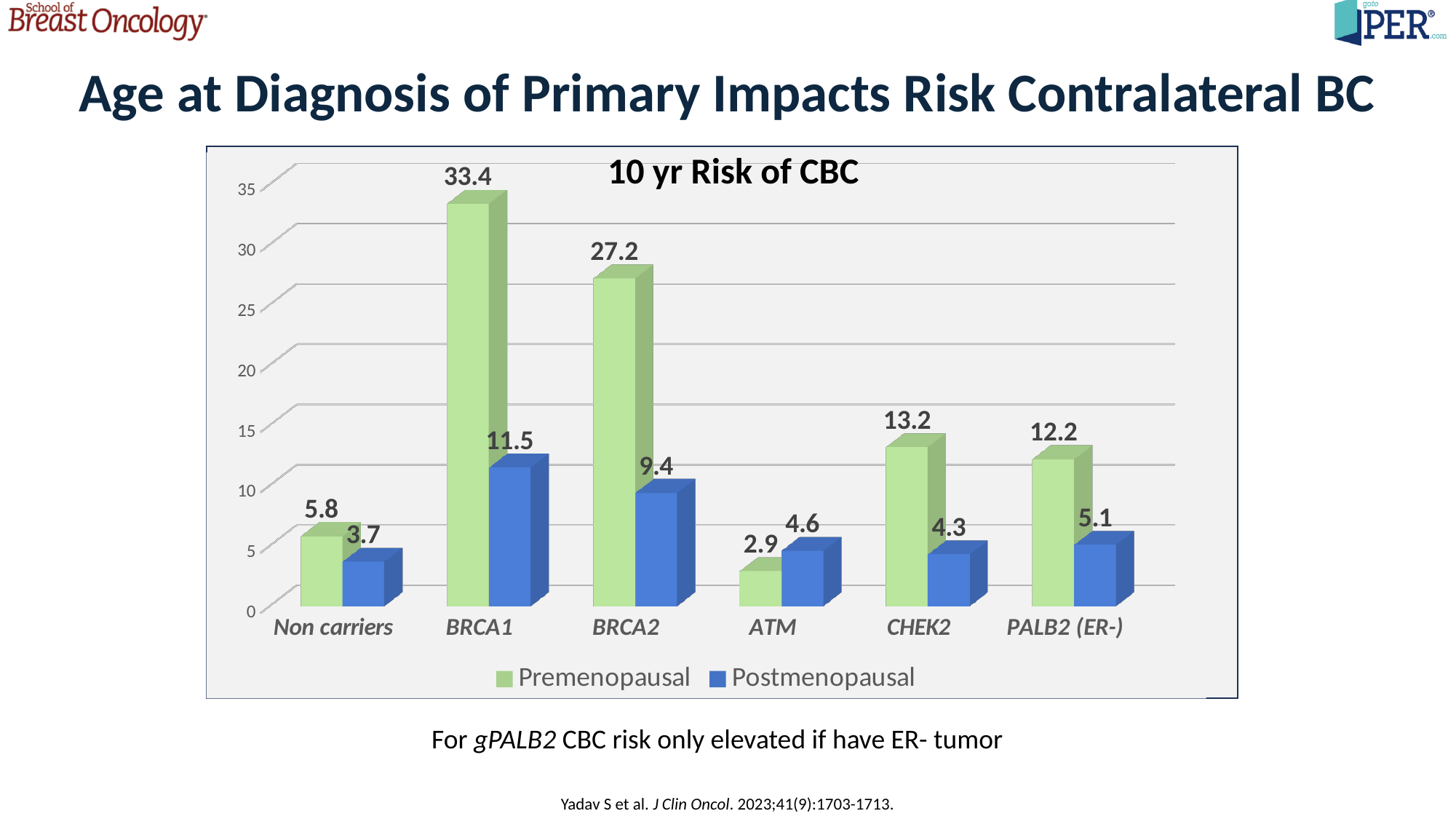
Is the Premenopausal value for CHEK2 greater or less than 10? greater What is the Premenopausal value for BRCA1? 33.4 Which category has the highest Premenopausal value? BRCA1 What is the title of the chart? 10 yr Risk of CBC Which is larger for ATM, the Premenopausal value or the Postmenopausal value? Postmenopausal What is the Premenopausal value for ATM? 2.9 What is the difference between the Premenopausal and Postmenopausal values for BRCA1? 21.9 What kind of chart is shown? Bar chart How many categories are shown on the x axis? 6 How many series does the legend list? 2 What is the Postmenopausal value for BRCA2? 9.4 Which category has the lowest Postmenopausal value? Non carriers